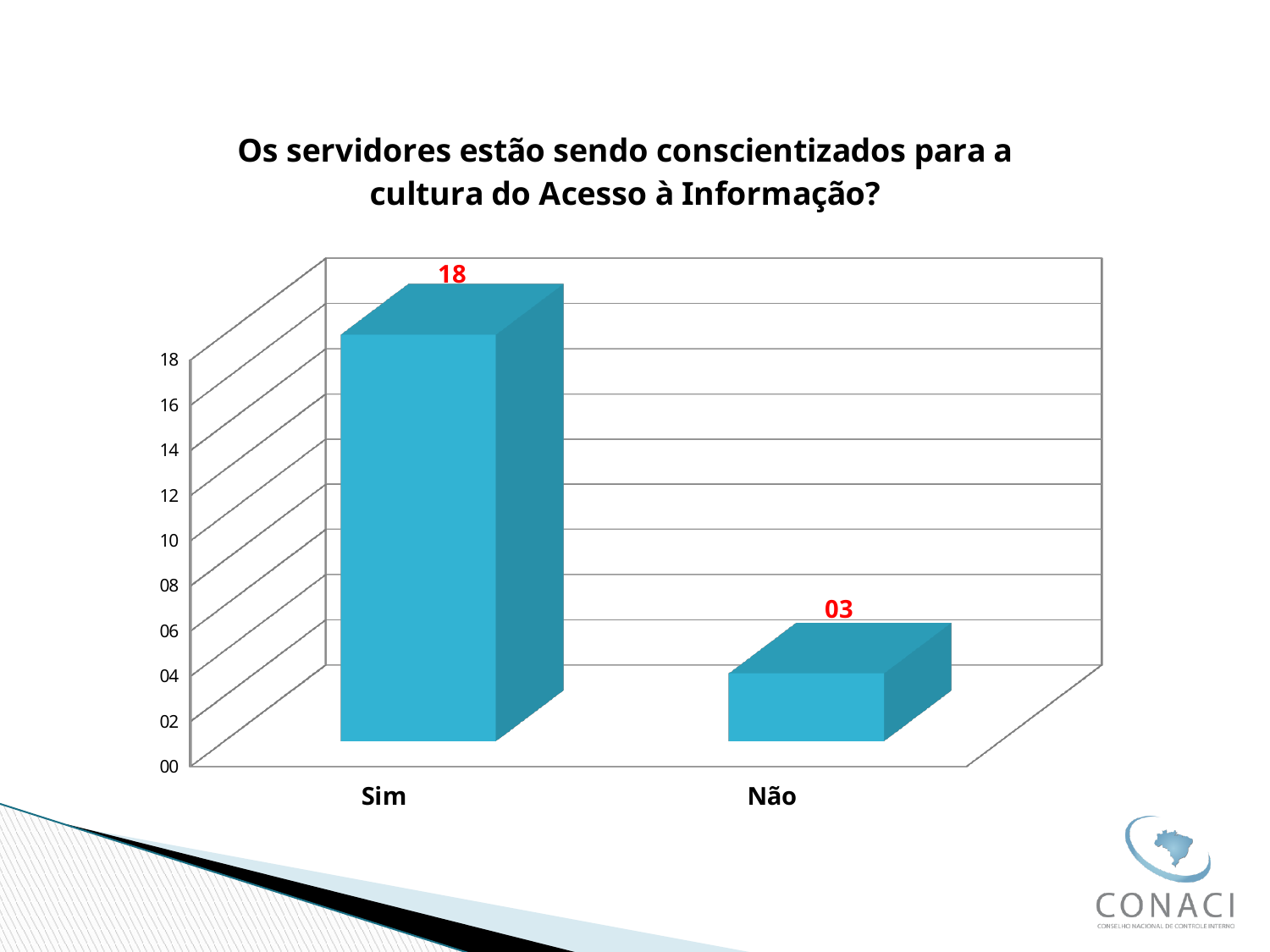
What colour are the bars in the chart? blue What is the difference between the values for Sim and Não? 15 Is the value for Não greater or less than 06? less How many categories are shown on the x axis? 2 Which category has the lowest value? Não What is the value for Não? 03 What is the value for Sim? 18 What kind of chart is shown on the slide? bar chart Which is larger, the value for Sim or the value for Não? Sim Which category has the highest value? Sim What is the title of the chart? Os servidores estão sendo conscientizados para a cultura do Acesso à Informação? Is the value for Sim greater or less than 10? greater